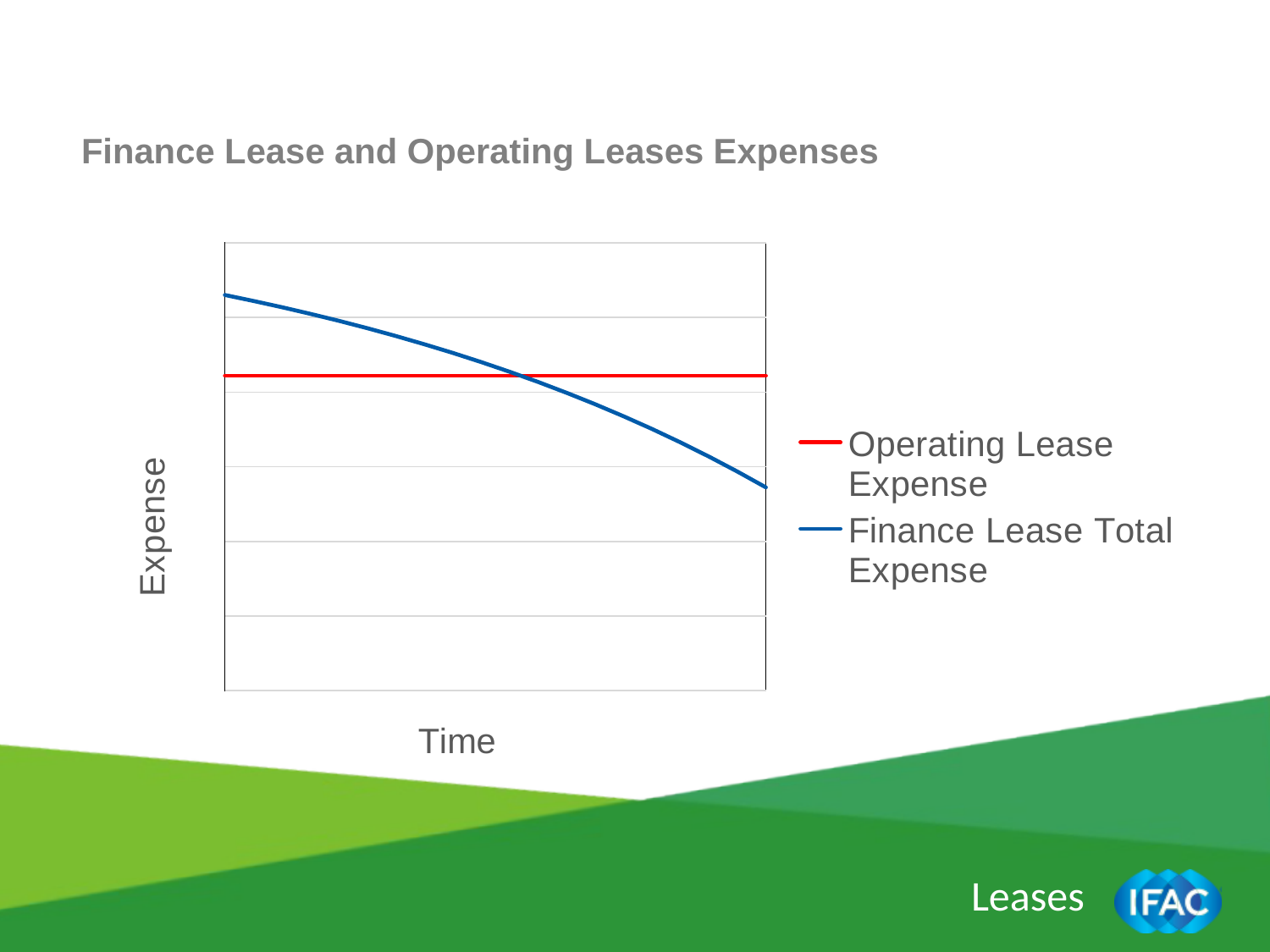
What is the label on the horizontal axis? Time What kind of chart is shown on the slide? Line chart What colour is the Finance Lease Total Expense line? Blue How many series does the legend list? 2 At the end of the time axis, which series is higher: Operating Lease Expense or Finance Lease Total Expense? Operating Lease Expense At the start of the time axis, which series is higher: Operating Lease Expense or Finance Lease Total Expense? Finance Lease Total Expense What is the label on the vertical axis? Expense Does the Finance Lease Total Expense line rise or fall over time? Fall Does the Operating Lease Expense line rise, fall, or stay flat over time? Stay flat